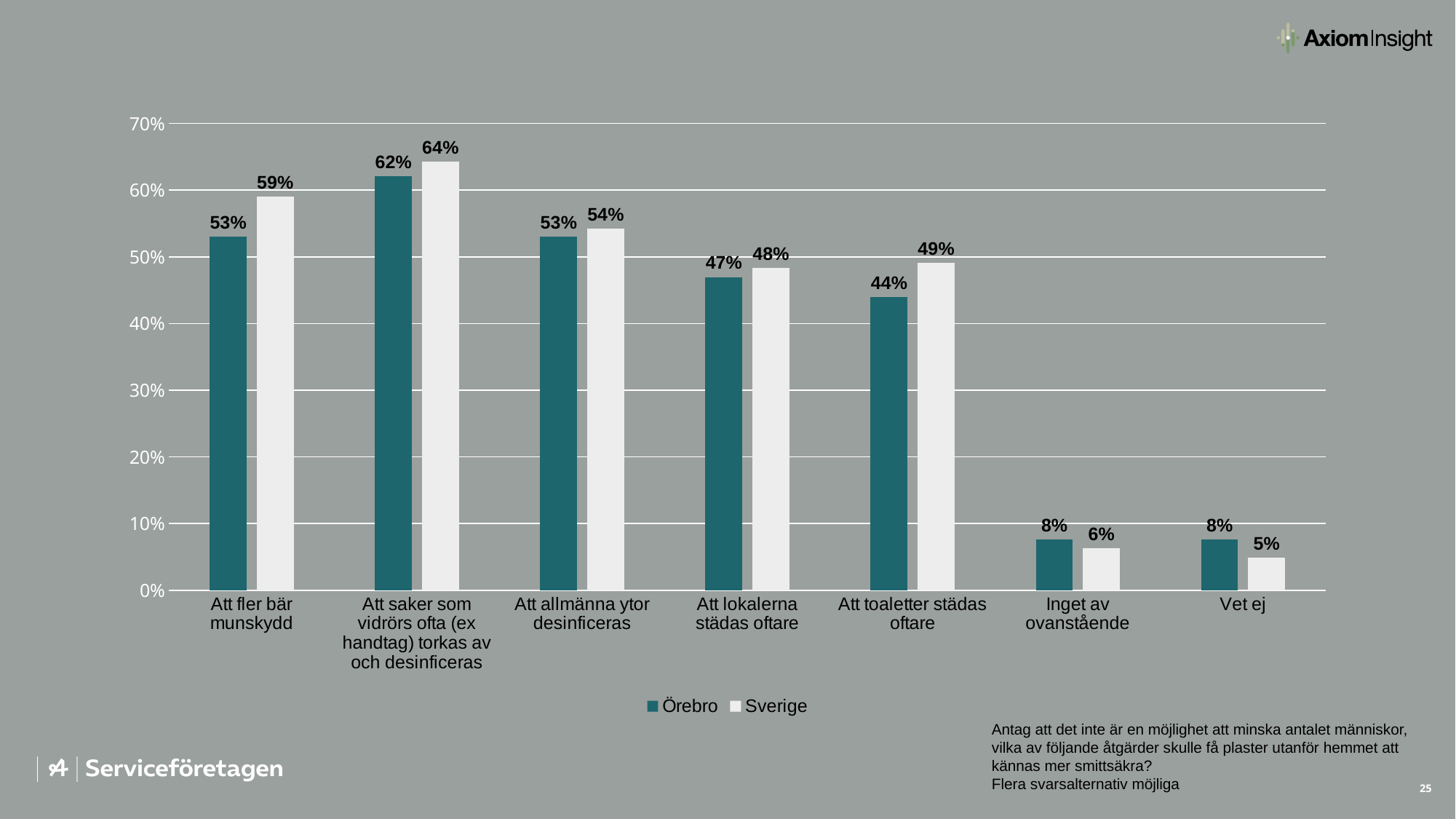
How many series does the legend list? 2 What is the difference between the Sverige and Örebro values for "Att fler bär munskydd"? 6% What is the value for Örebro for "Att toaletter städas oftare"? 44% What kind of chart is shown on the slide? Bar chart What is the value for Sverige for "Vet ej"? 5% What are the two series named in the legend? Örebro and Sverige Which category has the lowest value for Sverige? Vet ej What is the value for Örebro for "Att fler bär munskydd"? 53% For "Inget av ovanstående", which series has the larger value, Örebro or Sverige? Örebro How many categories are shown on the x axis? 7 What is the value for Sverige for "Att saker som vidrörs ofta (ex handtag) torkas av och desinficeras"? 64% Which category has the highest value for Örebro? Att saker som vidrörs ofta (ex handtag) torkas av och desinficeras